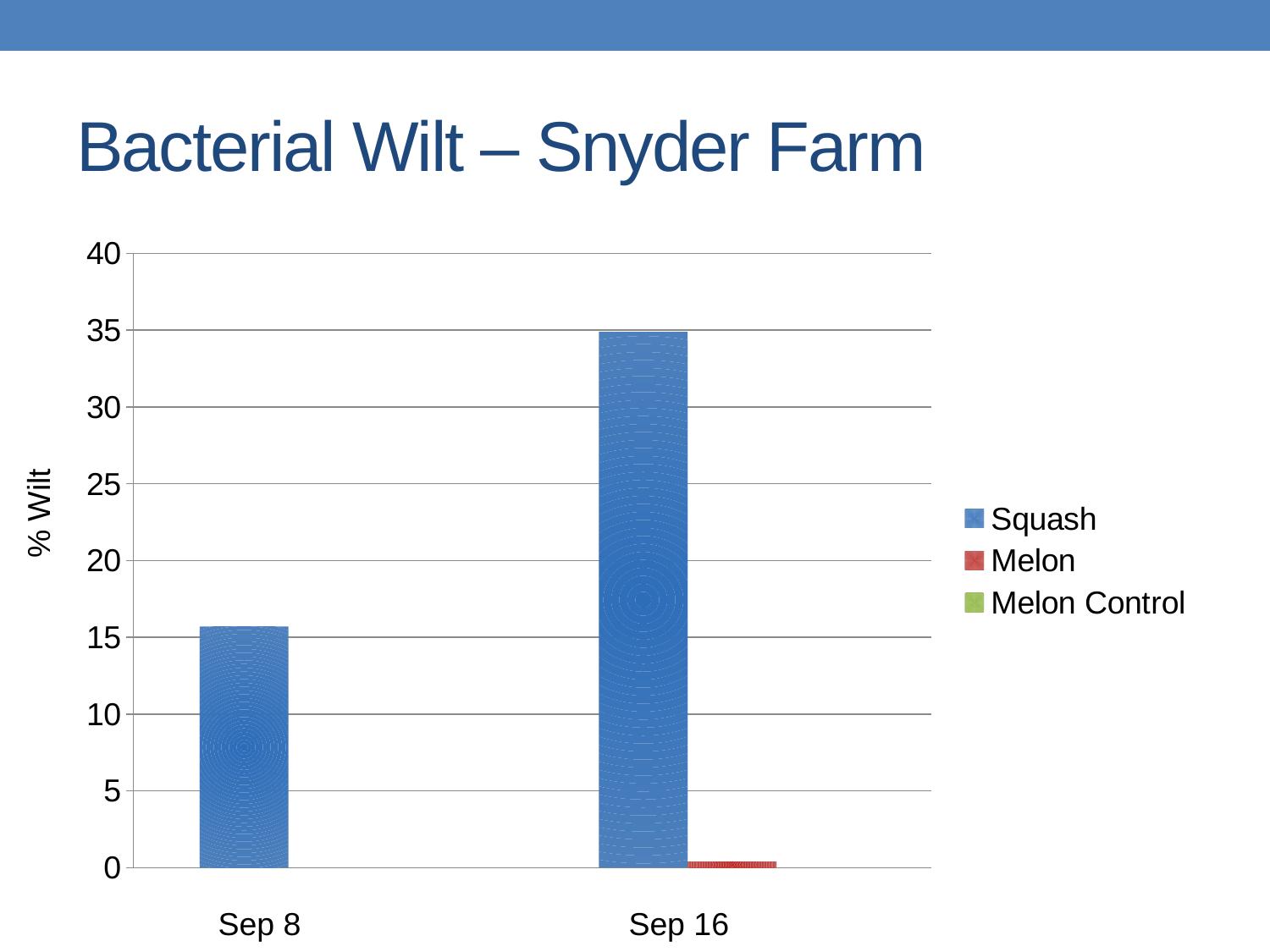
Is the Squash value for Sep 16 greater or less than 30? greater On Sep 16, which series has the larger value, Squash or Melon? Squash Does the Squash value rise or fall from Sep 8 to Sep 16? rise Is the Squash value for Sep 8 greater or less than 20? less Which date has the higher Squash value, Sep 8 or Sep 16? Sep 16 How many date categories are shown on the x axis? 2 What is the title of the slide containing the chart? Bacterial Wilt – Snyder Farm How many series does the legend list? 3 What kind of chart is shown on the slide? bar chart What is the label on the vertical axis? % Wilt Is the Melon value for Sep 16 greater or less than 5? less